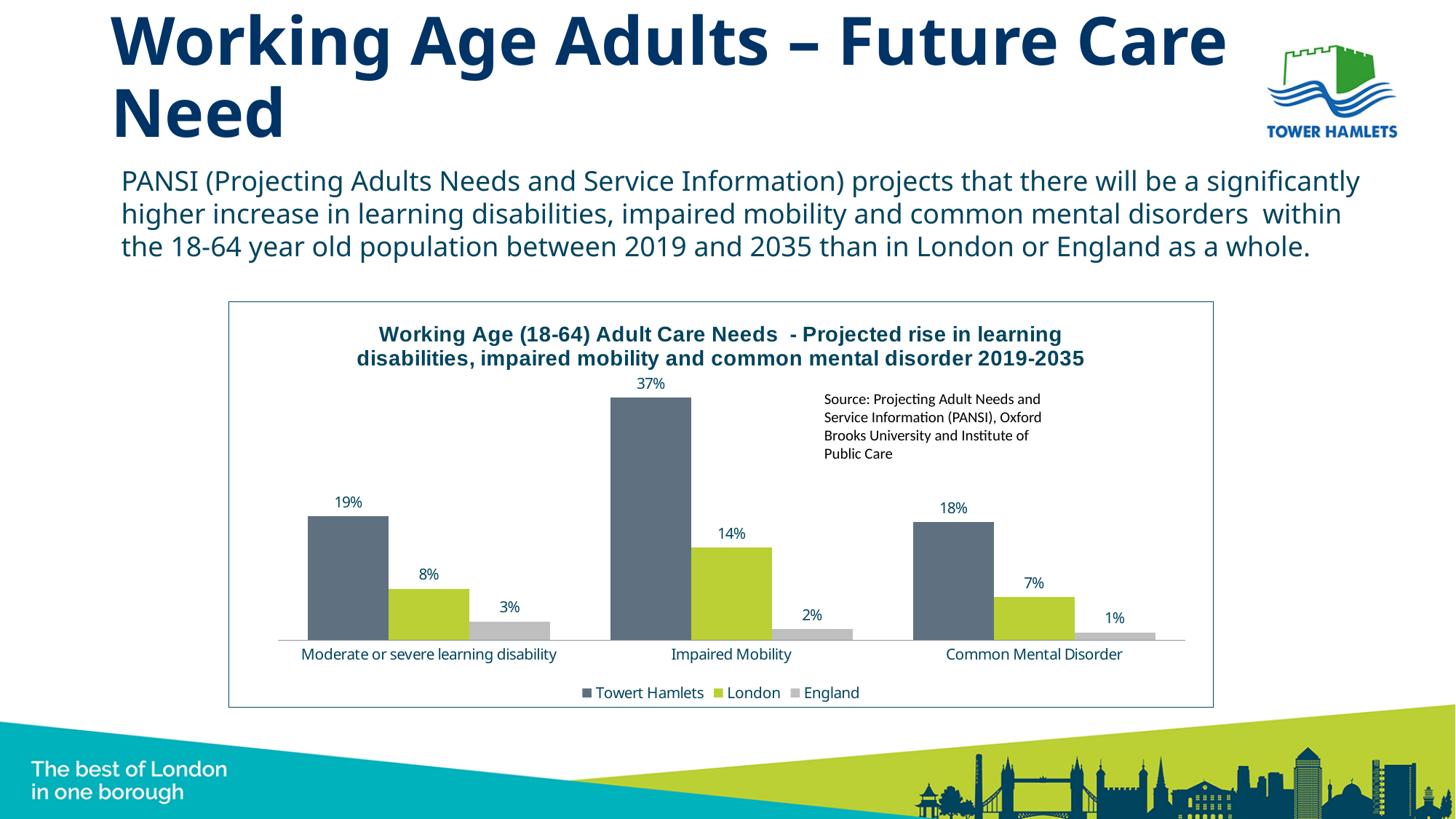
How many series does the legend list? 3 What is the difference between the Tower Hamlets and London values for Impaired Mobility? 23% What kind of chart is shown on the slide? Bar chart What is the difference between the London and England values for Common Mental Disorder? 6% What is the projected rise for Tower Hamlets in Impaired Mobility? 37% Which series is shown in green in the legend? London Which category has the highest value for Tower Hamlets? Impaired Mobility How many categories are shown on the x axis? 3 What is the projected rise for England in Common Mental Disorder? 1% Which is larger: the Tower Hamlets value for Moderate or severe learning disability or the Tower Hamlets value for Common Mental Disorder? Moderate or severe learning disability What is the projected rise for London in Moderate or severe learning disability? 8% Which category has the lowest value for England? Common Mental Disorder